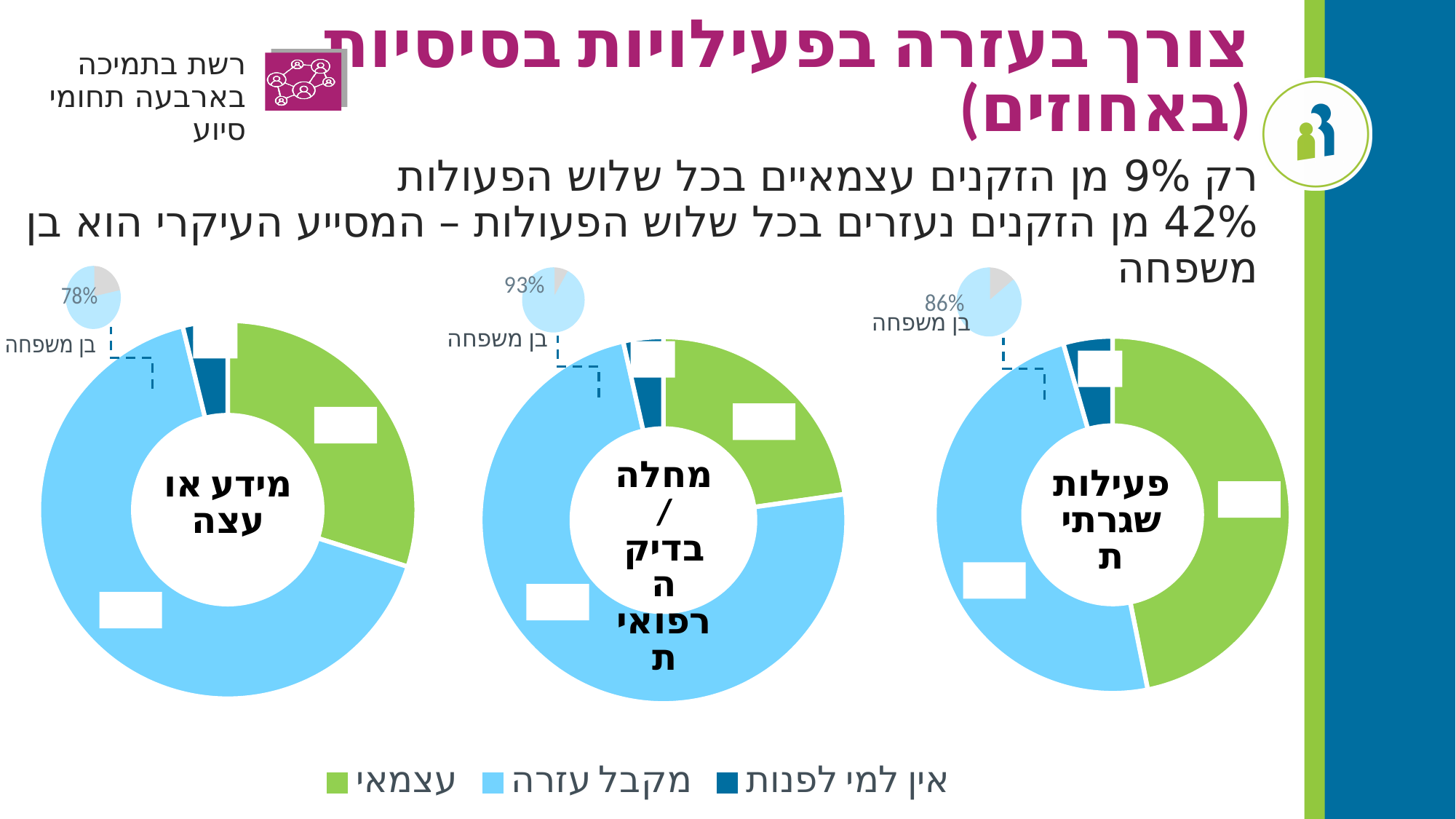
Among the three small 'בן משפחה' pies, which activity has the highest percentage? מחלה / בדיקה רפואית In the 'מידע או עצה' donut chart, which series has the smallest segment? אין למי לפנות How many donut charts are shown on the slide? 3 In the small pie above the 'מידע או עצה' chart, what percentage is shown for 'בן משפחה'? 78% What kind of charts are shown on the slide? Donut (pie) charts Among the three small 'בן משפחה' pies, which activity has the lowest percentage? מידע או עצה In the 'מחלה / בדיקה רפואית' donut chart, which series has the largest segment? מקבל עזרה In the small pie above the 'פעילות שגרתית' chart, what percentage is shown for 'בן משפחה'? 86% How many series does the legend at the bottom of the slide list? 3 Which is larger: the 'בן משפחה' percentage for 'פעילות שגרתית' or for 'מידע או עצה'? פעילות שגרתית What is the difference between the 'בן משפחה' percentage for 'מחלה / בדיקה רפואית' and for 'מידע או עצה'? 15 percentage points In the small pie above the 'מחלה / בדיקה רפואית' chart, what percentage is shown for 'בן משפחה'? 93%